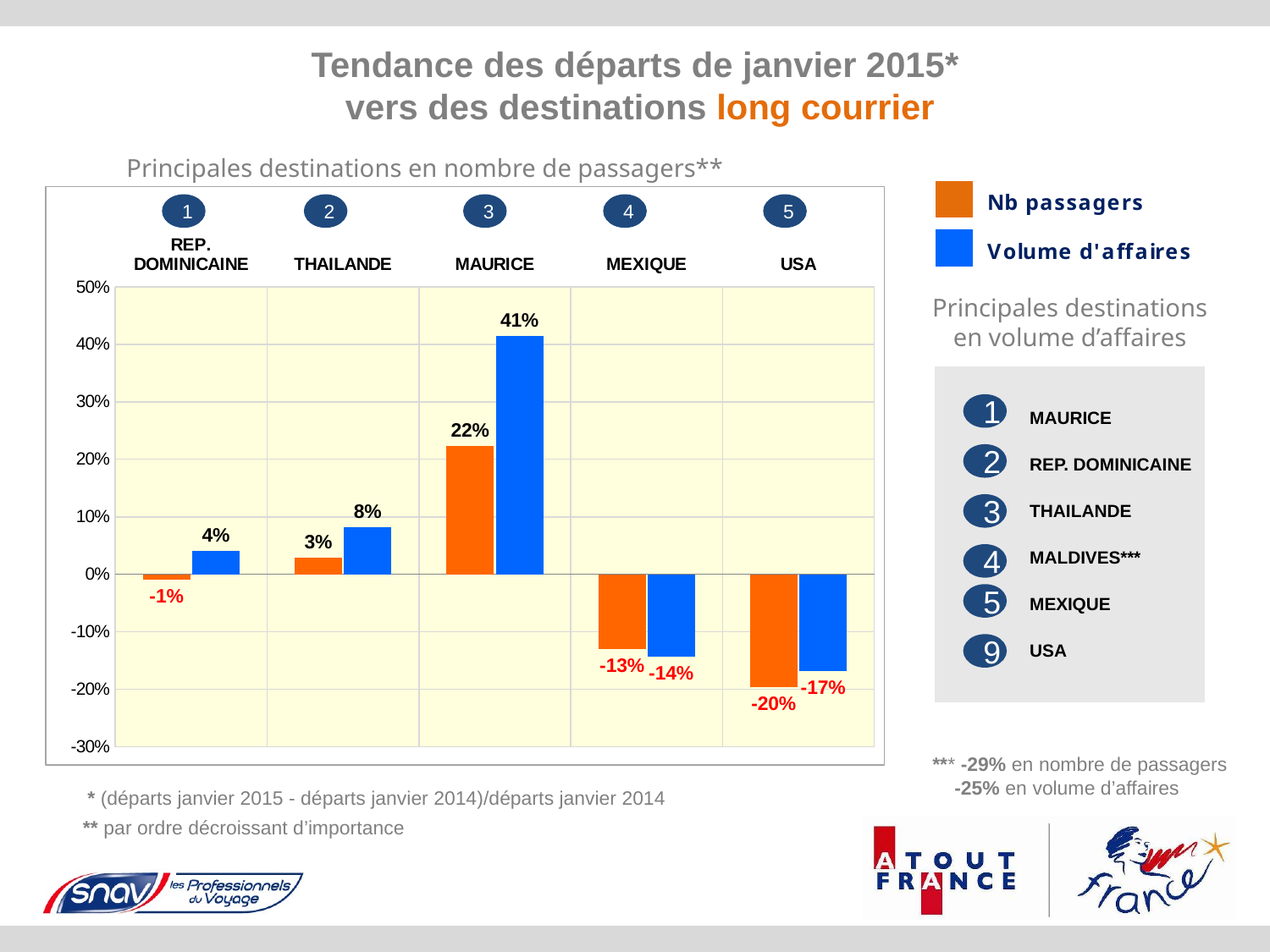
What is the Nb passagers value for USA? -20% Which is larger for REP. DOMINICAINE: the Nb passagers value or the Volume d'affaires value? Volume d'affaires What is the difference between the Volume d'affaires and Nb passagers values for MAURICE? 19 percentage points Which colour represents Nb passagers in the chart? Orange How many series does the legend list? 2 What is the Volume d'affaires value for MEXIQUE? -14% What kind of chart is shown on the slide? Bar chart Which destination has the lowest Nb passagers value? USA What is the Volume d'affaires value for THAILANDE? 8% What is the Nb passagers value for MAURICE? 22% Which destination has the highest Volume d'affaires value? MAURICE How many destinations are shown on the x axis of the chart? 5